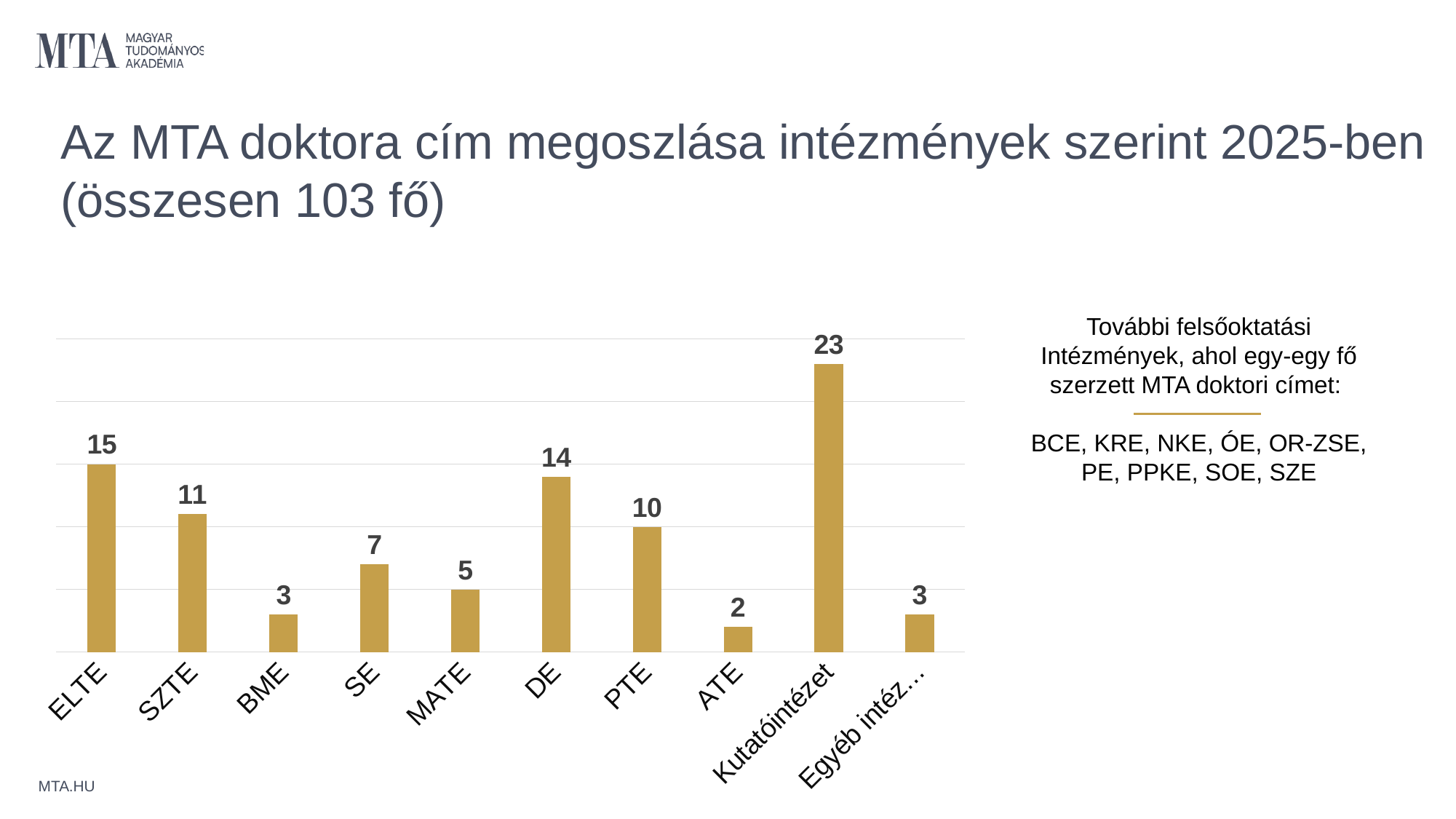
How many categories are shown on the x axis? 10 Which category has the lowest value? ATE What is the value for ATE? 2 What is the value for ELTE? 15 What is the total number of people mentioned in the slide title? 103 fő What is the value for DE? 14 What is the value for Kutatóintézet? 23 What kind of chart is shown on the slide? Bar chart Which category has the highest value? Kutatóintézet Which is larger, the value for SE or the value for MATE? SE What is the difference between the values for Kutatóintézet and ELTE? 8 What is the difference between the values for SZTE and PTE? 1